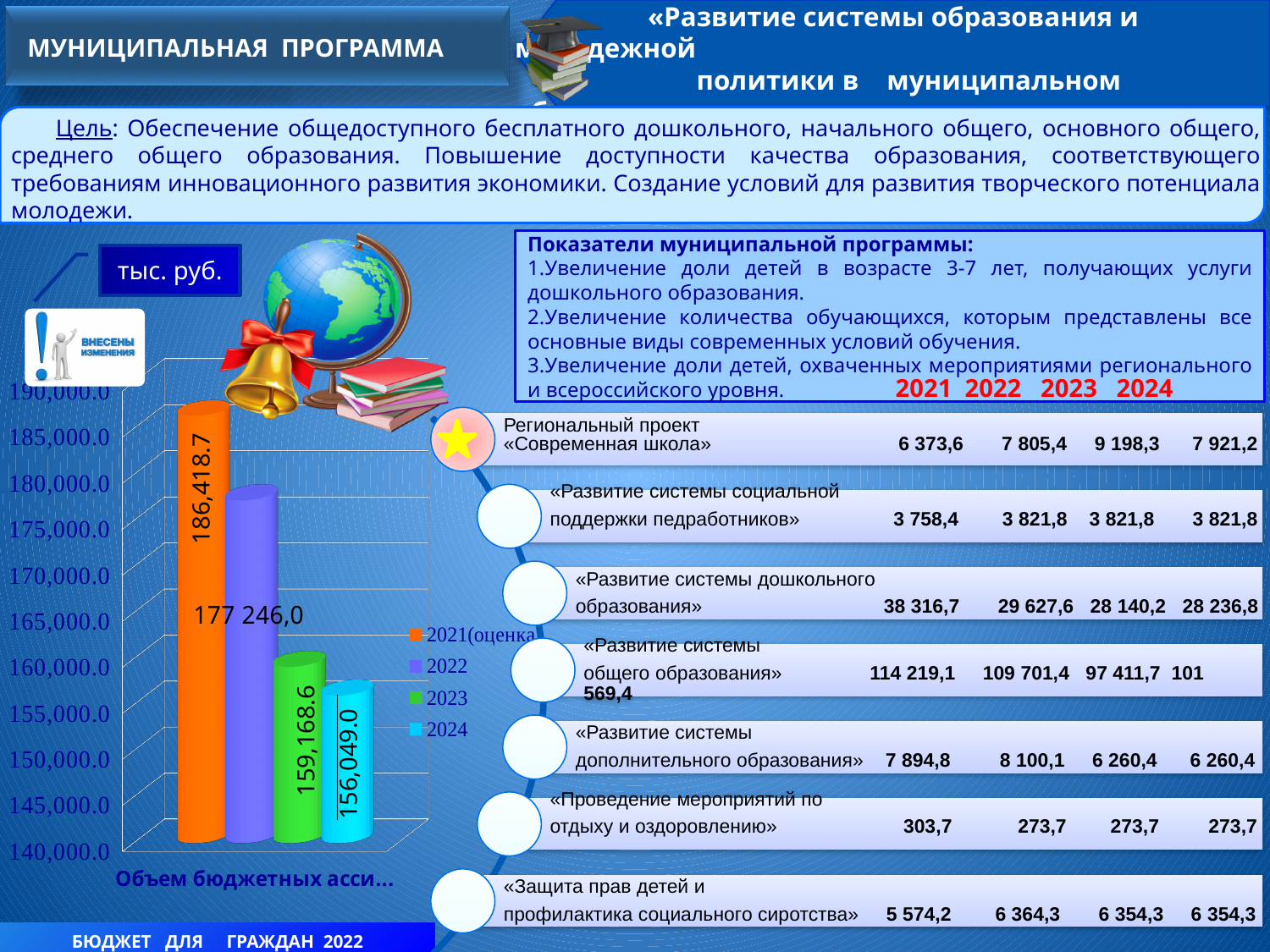
How many entries does the legend of the bar chart list? 4 What is the value for 2024 in the bar chart? 156,049.0 Which year has the highest value in the bar chart? 2021(оценка) Is the value for 2024 in the bar chart greater or less than 160,000.0? less What is the value for 2023 in the bar chart? 159,168.6 What is the value for 2022 in the bar chart? 177 246,0 Which year has the lowest value in the bar chart? 2024 What kind of chart is shown on the left of the slide? bar chart How many bars are plotted in the bar chart? 4 Do the values in the bar chart rise or fall from 2021(оценка) to 2024? fall What is the value for 2021(оценка) in the bar chart? 186,418.7 Which is larger in the bar chart, the value for 2022 or the value for 2023? 2022